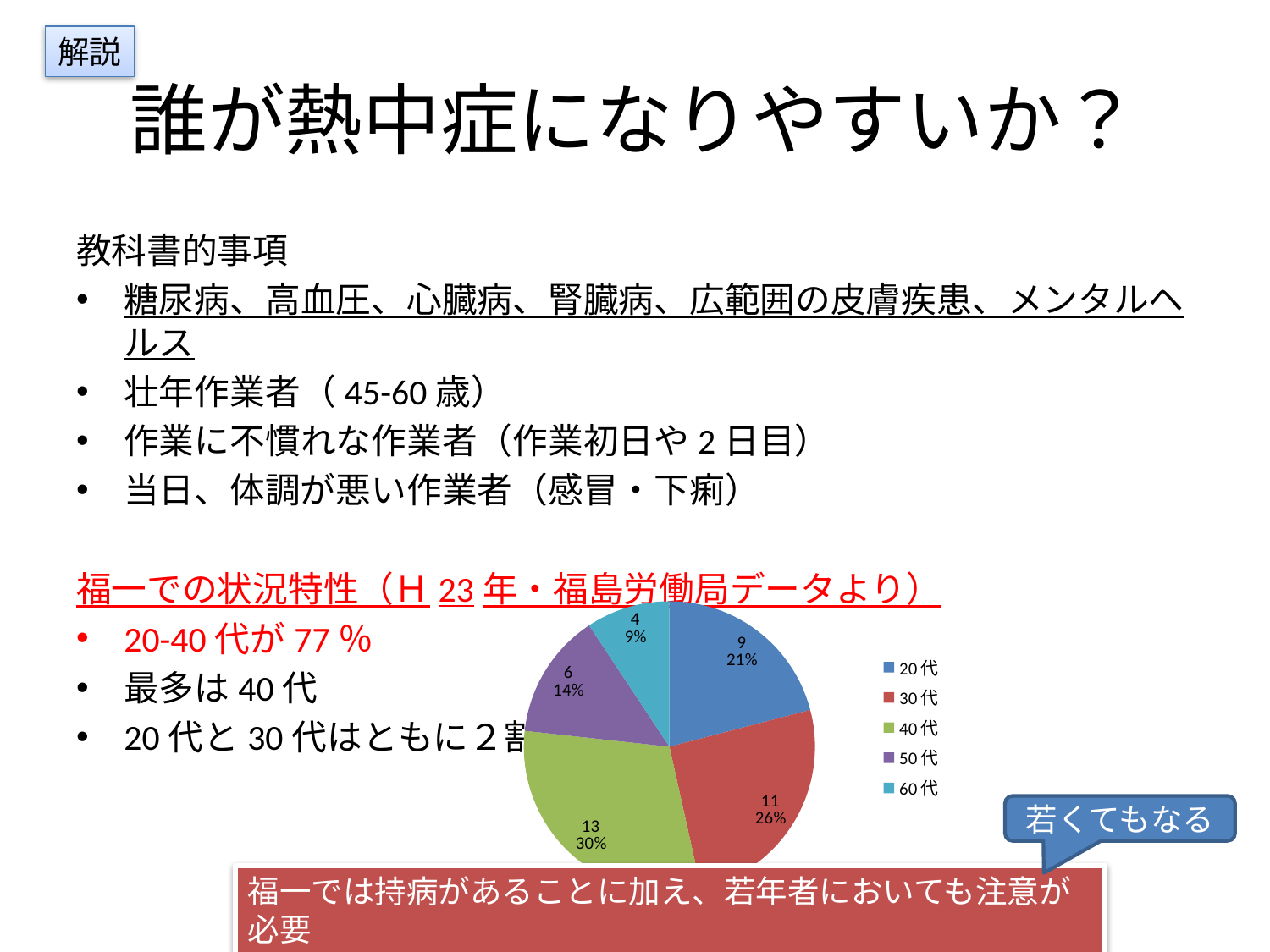
What is the difference between the counts for 40代 and 20代 in the pie chart? 4 What share of the pie does the 20代 slice represent? 21% What count is shown for the 60代 slice of the pie chart? 4 What percentage is shown for the 30代 slice of the pie chart? 26% What count is shown for the 40代 slice of the pie chart? 13 What kind of chart is shown on the slide? pie chart Which age group has the largest slice in the pie chart? 40代 Which age group has the smallest slice in the pie chart? 60代 Which is larger in the pie chart, the count for 30代 or the count for 50代? 30代 How many slices does the pie chart have? 5 How many entries does the legend of the pie chart list? 5 What percentage is shown for the 50代 slice of the pie chart? 14%